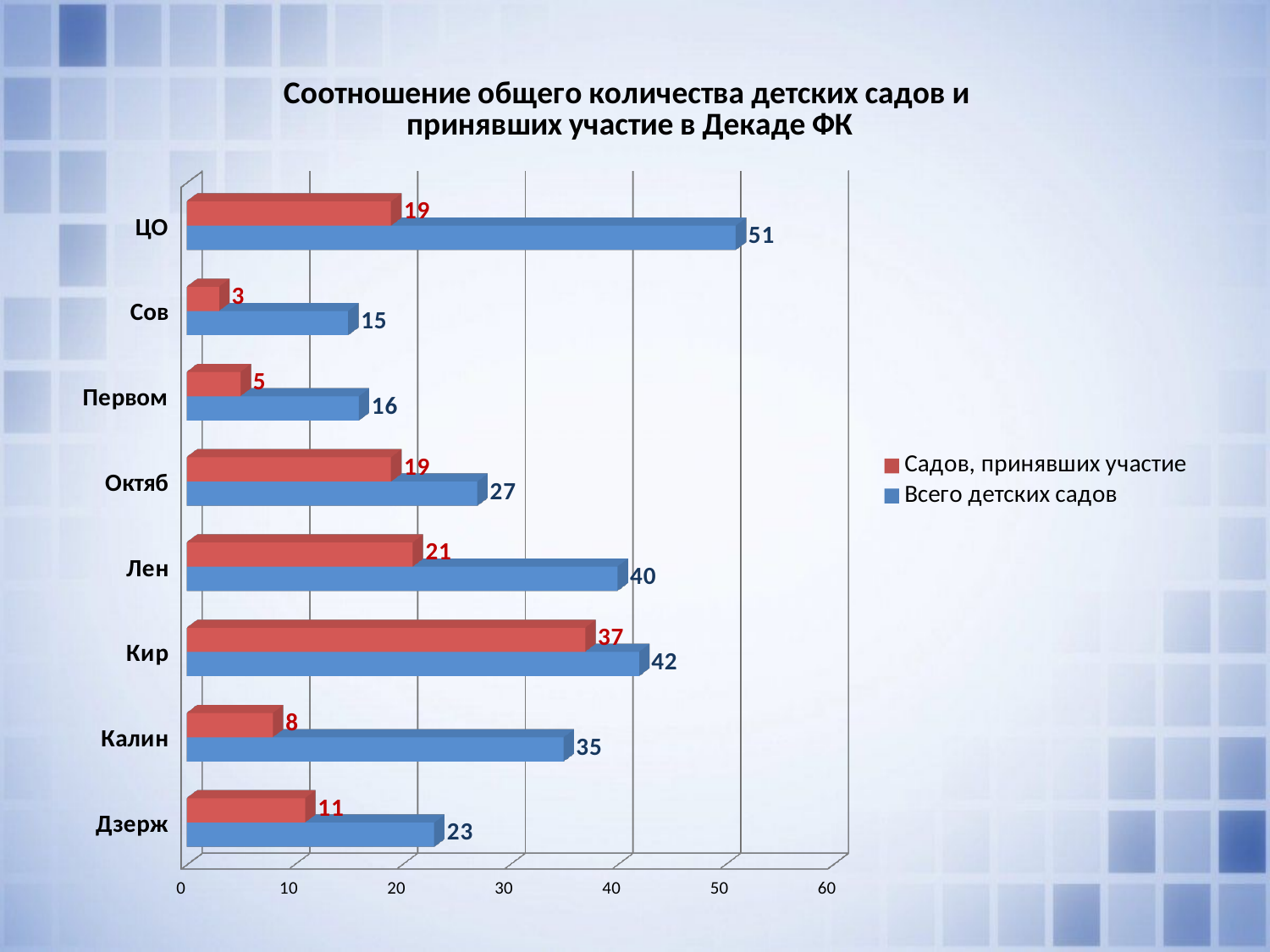
What is the value of "Всего детских садов" for ЦО? 51 Which category has the highest value for "Всего детских садов"? ЦО Which category has the lowest value for "Садов, принявших участие"? Сов How many categories are shown on the chart? 8 What is the value of "Садов, принявших участие" for Сов? 3 What kind of chart is shown on the slide? Bar chart What is the value of "Всего детских садов" for Дзерж? 23 What is the difference between "Всего детских садов" and "Садов, принявших участие" for Калин? 27 Which colour represents "Садов, принявших участие" in the legend? Red Which is larger: "Всего детских садов" for Лен or for Кир? Кир How many series does the legend list? 2 What is the value of "Садов, принявших участие" for Кир? 37